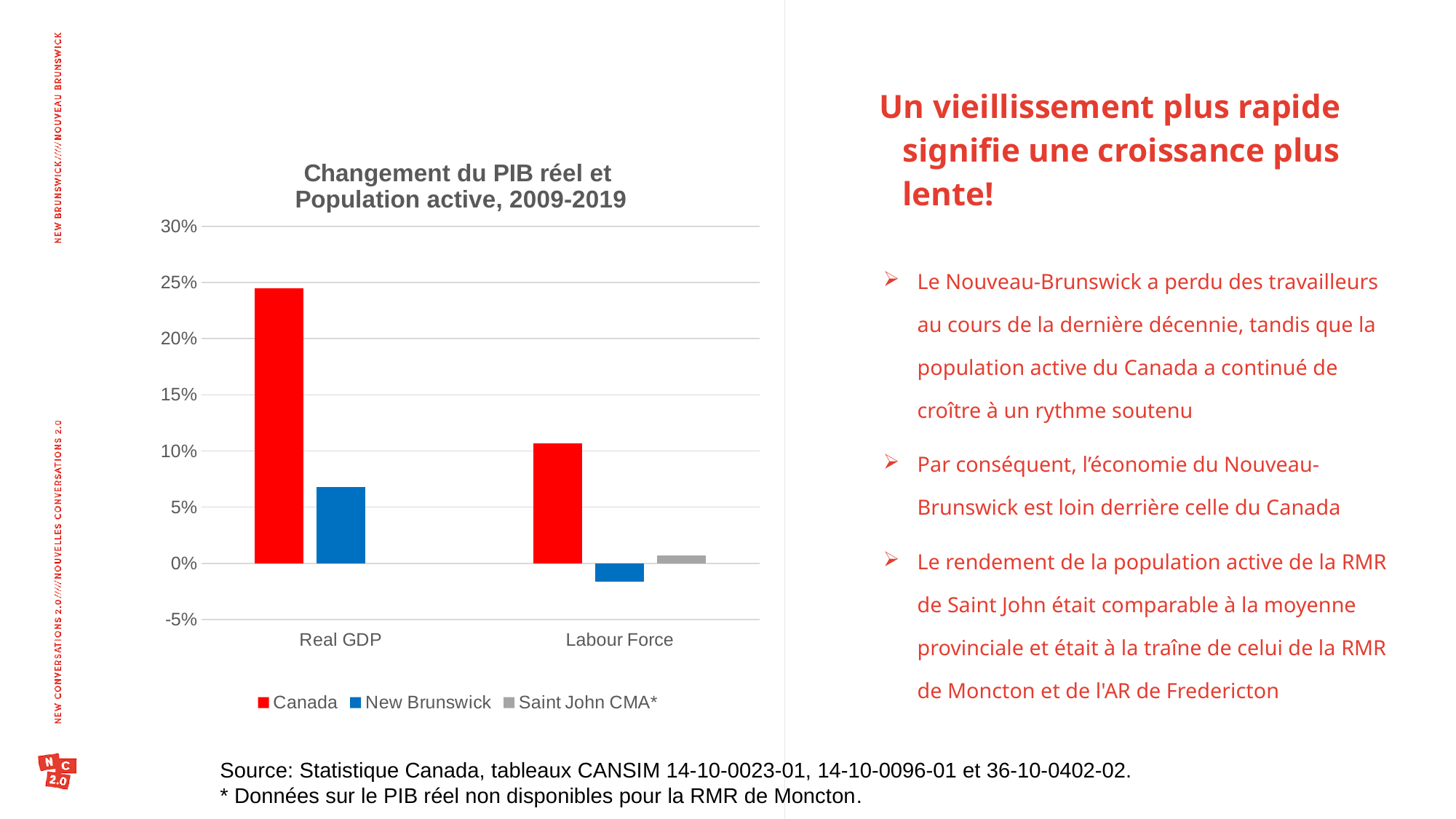
What is the title of the chart? Changement du PIB réel et Population active, 2009-2019 Which series is shown in grey in the legend? Saint John CMA* How many categories are shown on the x axis? 2 Is the value for New Brunswick in Real GDP greater or less than 10%? less How many series does the legend list? 3 Which is larger: Canada's Real GDP change or Canada's Labour Force change? Real GDP Is the value for New Brunswick in Labour Force greater or less than 0%? less Is the value for Canada in Labour Force greater or less than 10%? greater What kind of chart is shown on the slide? bar chart Which series has the lowest value for Labour Force? New Brunswick Which series has the highest value for Real GDP? Canada